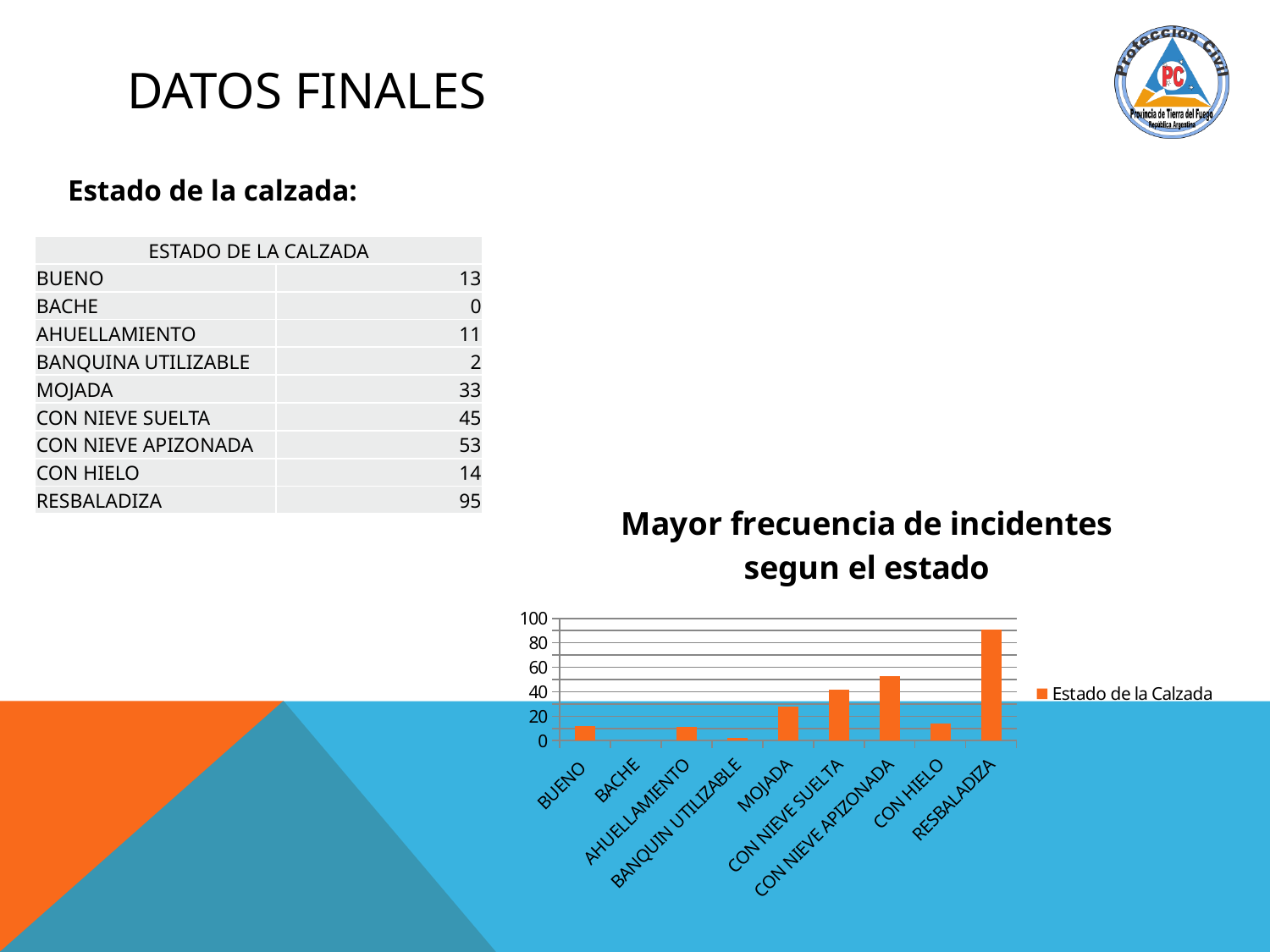
What is the title of the chart? Mayor frecuencia de incidentes segun el estado Which category has the lowest bar in the chart? BACHE According to the table on the slide, what is the value for RESBALADIZA? 95 What kind of chart is shown on the slide? bar chart Is the value for CON HIELO greater or less than 20? less Which category has the highest bar in the chart? RESBALADIZA Is the value for RESBALADIZA greater or less than 80? greater Which is larger, the bar for CON NIEVE APIZONADA or the bar for MOJADA? CON NIEVE APIZONADA According to the table on the slide, what is the difference between the values for CON NIEVE APIZONADA and CON NIEVE SUELTA? 8 How many categories are plotted along the x axis of the chart? 9 Is the value for CON NIEVE APIZONADA greater or less than 40? greater How many series does the chart legend list? 1